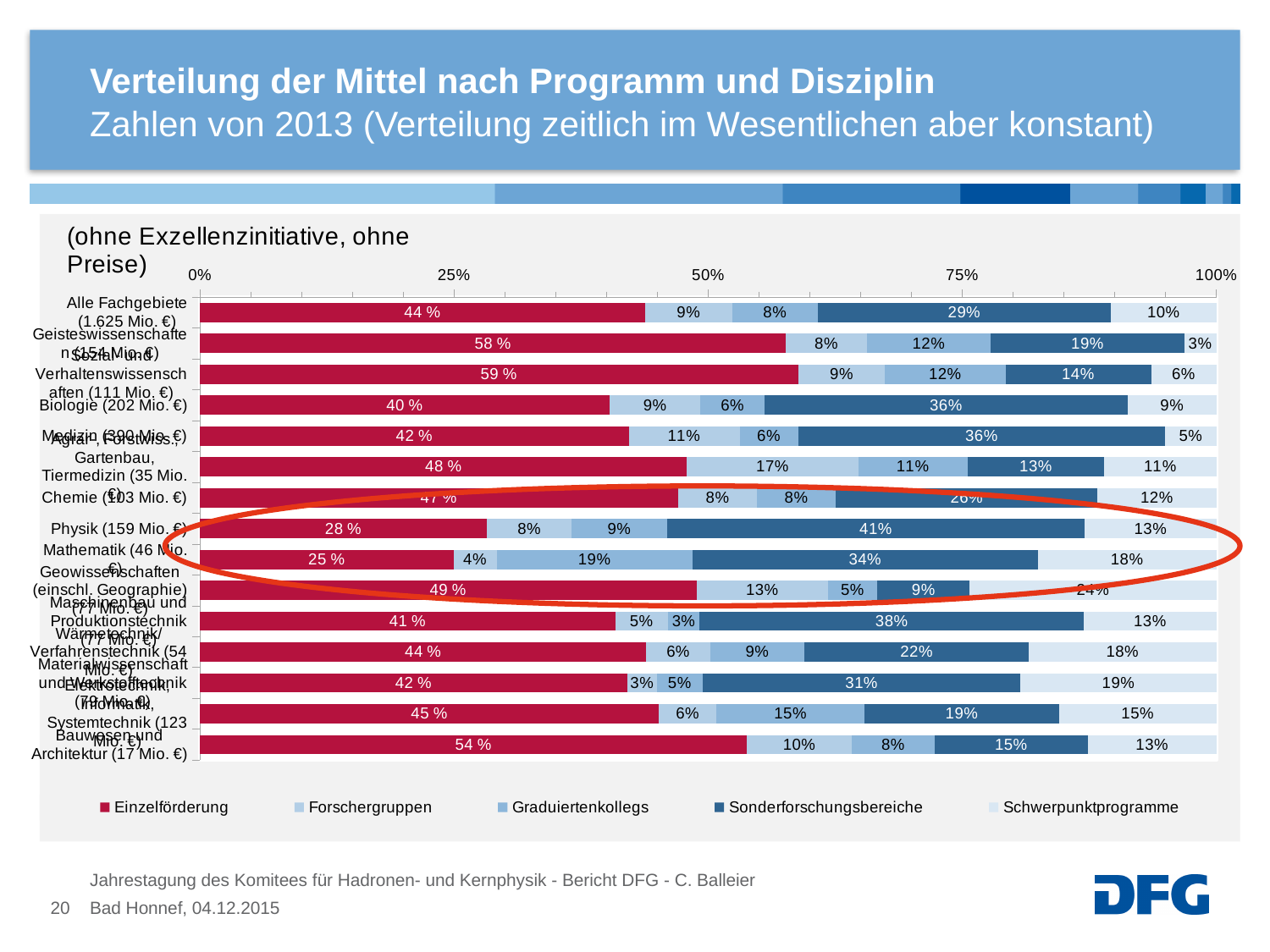
By how many percentage points does the Sonderforschungsbereiche share for Physik (41%) exceed that for Alle Fachgebiete (29%)? 12 percentage points Which two disciplines are highlighted by the red ellipse on the chart? Physik and Mathematik What is the Einzelförderung share for Alle Fachgebiete (1.625 Mio. €)? 44 % Which discipline has the lowest Einzelförderung share? Mathematik What is the Sonderforschungsbereiche share for Mathematik? 34% What is the Einzelförderung share for Mathematik (46 Mio. €)? 25 % Which has the larger Sonderforschungsbereiche share, Physik or Mathematik? Physik What is the Sonderforschungsbereiche share for Physik? 41% What is the Schwerpunktprogramme share for Mathematik? 18% What kind of chart is shown on the slide? Stacked bar chart What is the Einzelförderung share for Physik (159 Mio. €)? 28 % How many series does the legend list? 5